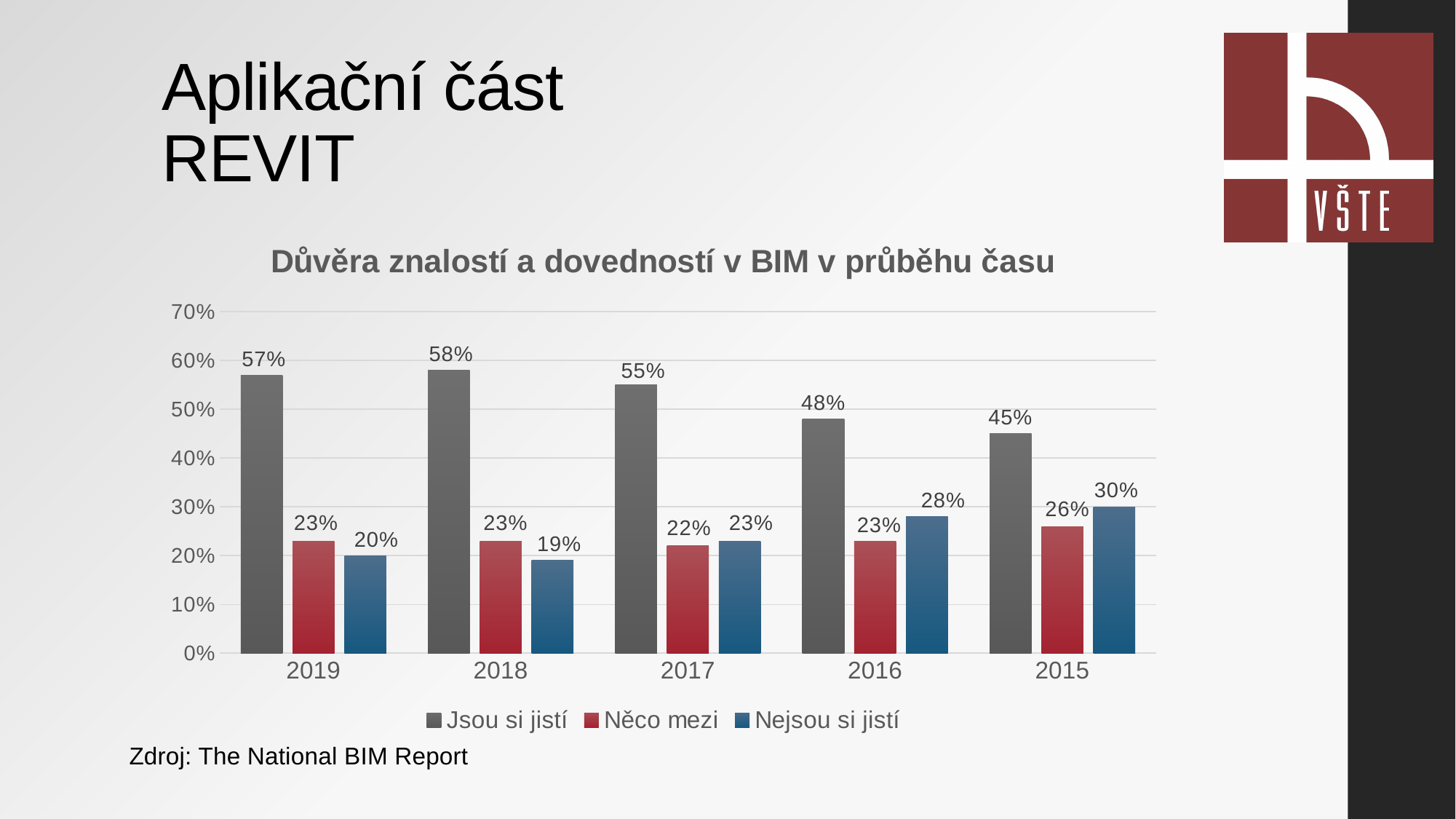
Which is larger in 2016: "Něco mezi" or "Nejsou si jistí"? Nejsou si jistí How many years are shown on the x axis? 5 In which year is the "Jsou si jistí" value highest? 2018 In which year is the "Nejsou si jistí" value lowest? 2018 What is the value for "Něco mezi" in 2017? 22% What is the value for "Jsou si jistí" in 2018? 58% What kind of chart is shown on the slide? bar chart What is the title of the chart? Důvěra znalostí a dovedností v BIM v průběhu času What is the value for "Nejsou si jistí" in 2015? 30% How many series does the legend list? 3 Is the value for "Jsou si jistí" in 2016 greater or less than 40%? greater What is the difference between the "Jsou si jistí" values for 2018 and 2015? 13%